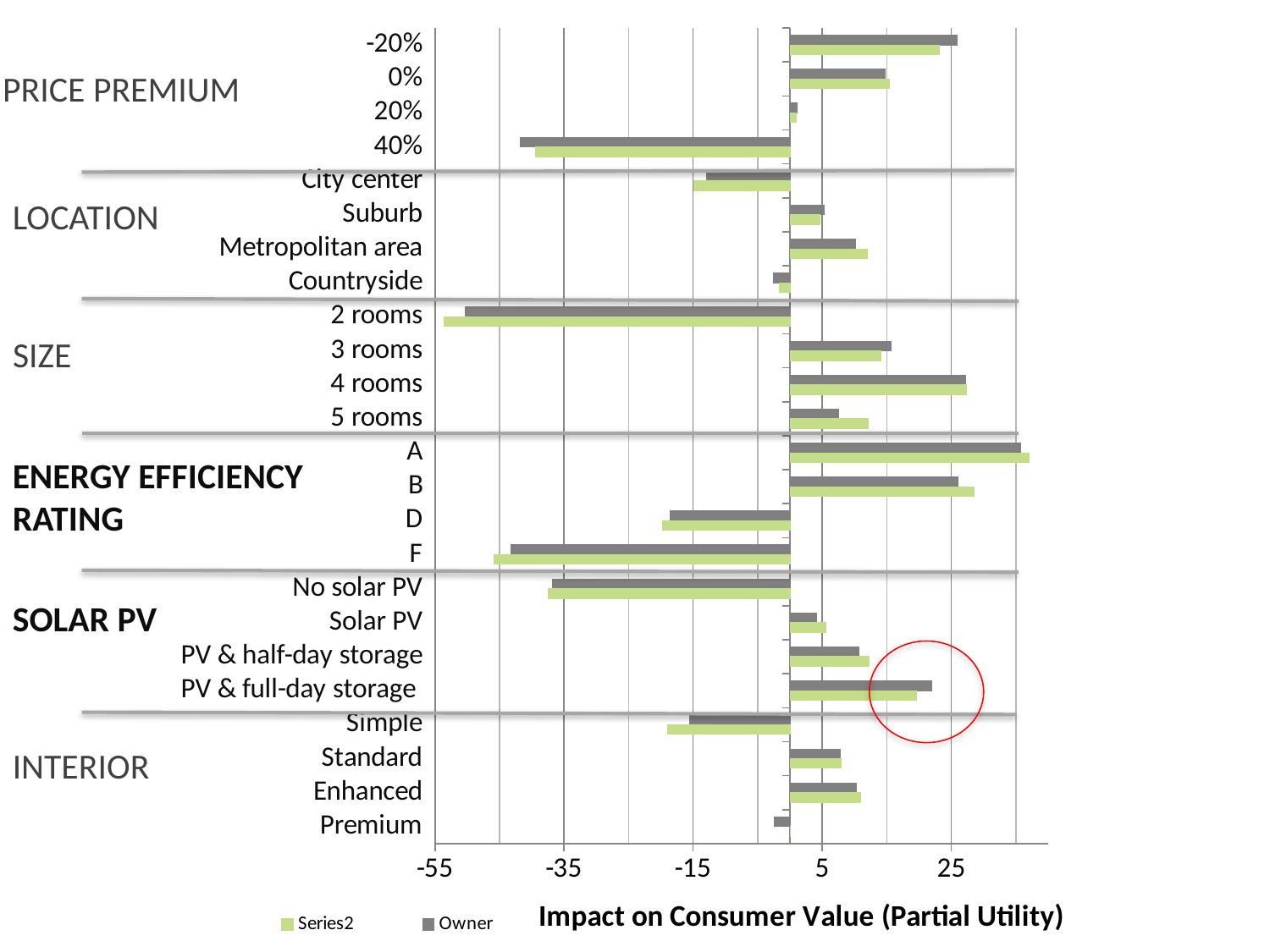
Which category has the highest Owner value? A How many categories are plotted on the vertical axis? 24 Which has the larger Owner value, 4 rooms or 5 rooms? 4 rooms Is the Owner value for No solar PV greater or less than -15? less Is the Owner value for A greater or less than 25? greater Which category has the lowest Series2 value? 2 rooms Is the Series2 value for 2 rooms greater or less than -35? less Which has the larger Series2 value, A or B? A How many series does the legend list? 2 What is the title of the horizontal axis? Impact on Consumer Value (Partial Utility) What are the two series named in the legend? Series2 and Owner What kind of chart is shown on the slide? bar chart